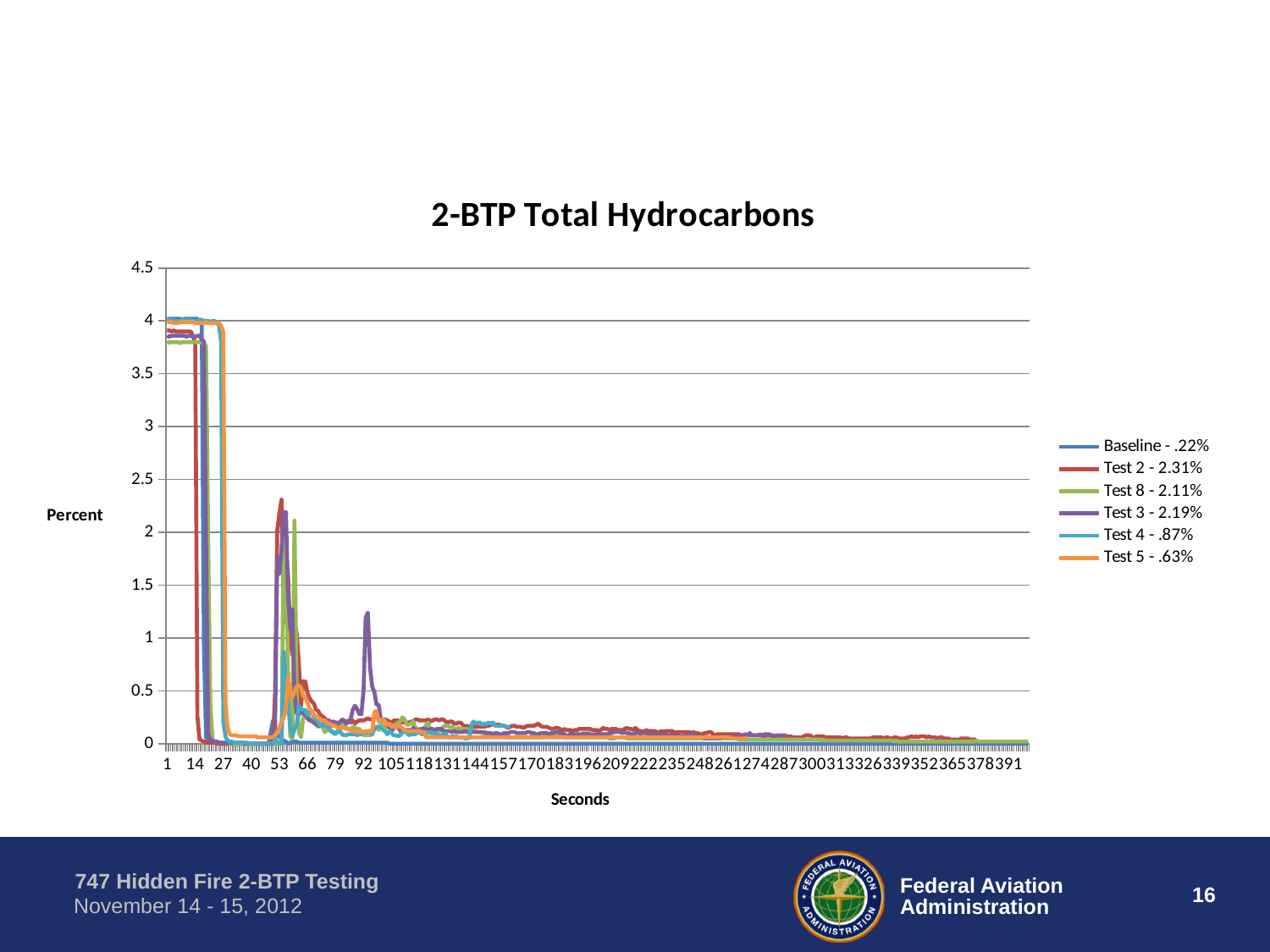
Overall, do the values rise or fall as seconds increase along the x axis? fall Is the value for Test 3 at its peak near 92 seconds greater or less than 1? greater Is the value for Baseline at 1 second greater or less than 3.5? greater How many series does the legend list? 6 What label is shown on the vertical axis of the chart? Percent Is the value for Test 2 at its peak near 53 seconds greater or less than 2? greater What kind of chart is shown on the slide? line chart What is the title of the chart? 2-BTP Total Hydrocarbons